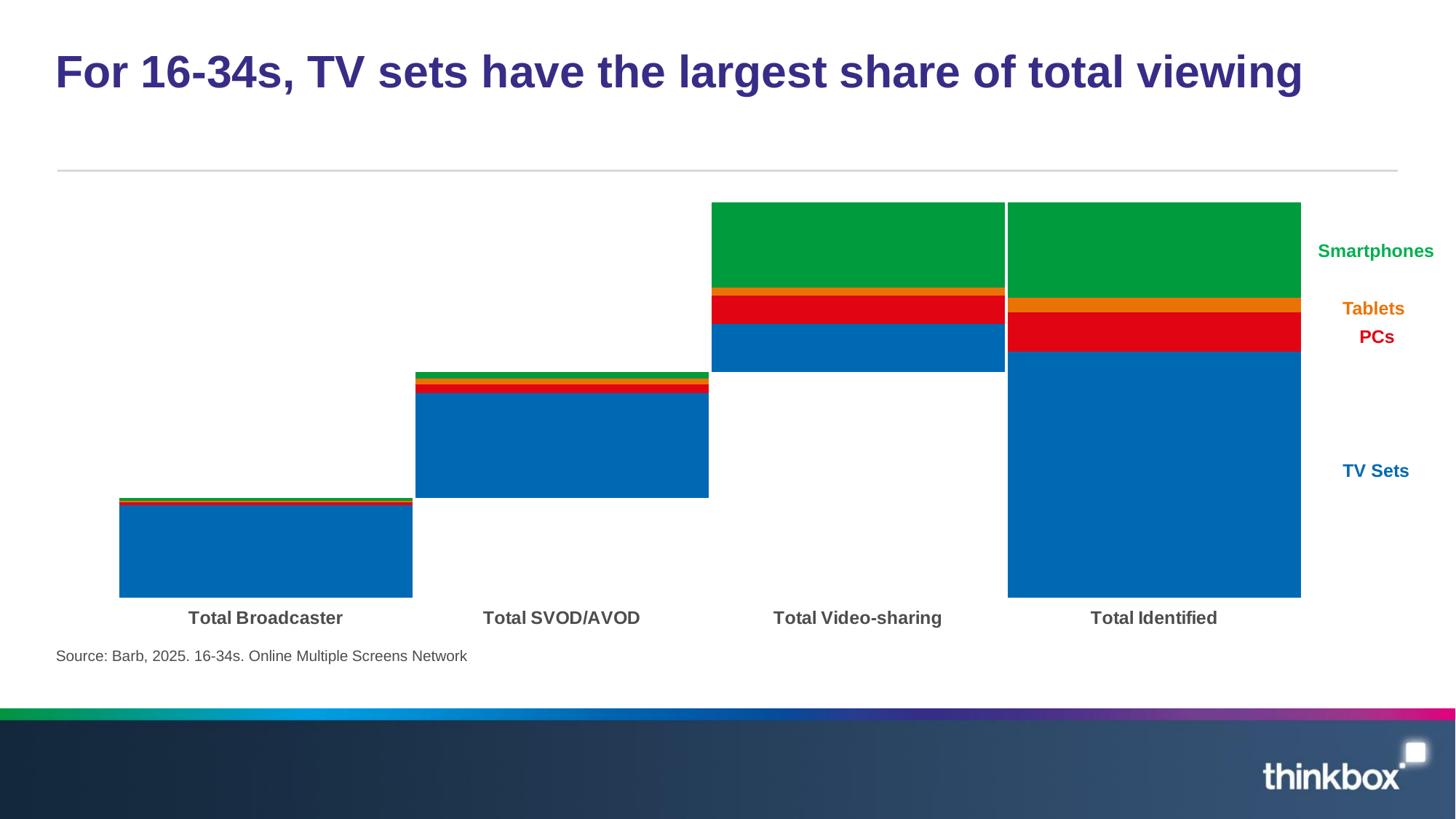
In the Total Identified bar, which device has the largest segment? TV Sets In the Total Identified bar, which is larger: the TV Sets segment or the Smartphones segment? TV Sets Which category has the smallest Smartphones segment? Total Broadcaster How many device series does the chart's legend list? 4 Which colour represents TV Sets in the chart? Blue What kind of chart is shown on the slide? Stacked bar chart How many categories are shown along the x axis of the chart? 4 Which category has the largest TV Sets segment? Total Identified Which device type is shown in green in the chart? Smartphones In the Total Video-sharing bar, which is larger: the PCs segment or the Tablets segment? PCs In the Total Video-sharing bar, which device has the smallest segment? Tablets In the Total Video-sharing bar, is the Smartphones segment larger or smaller than the TV Sets segment? Larger